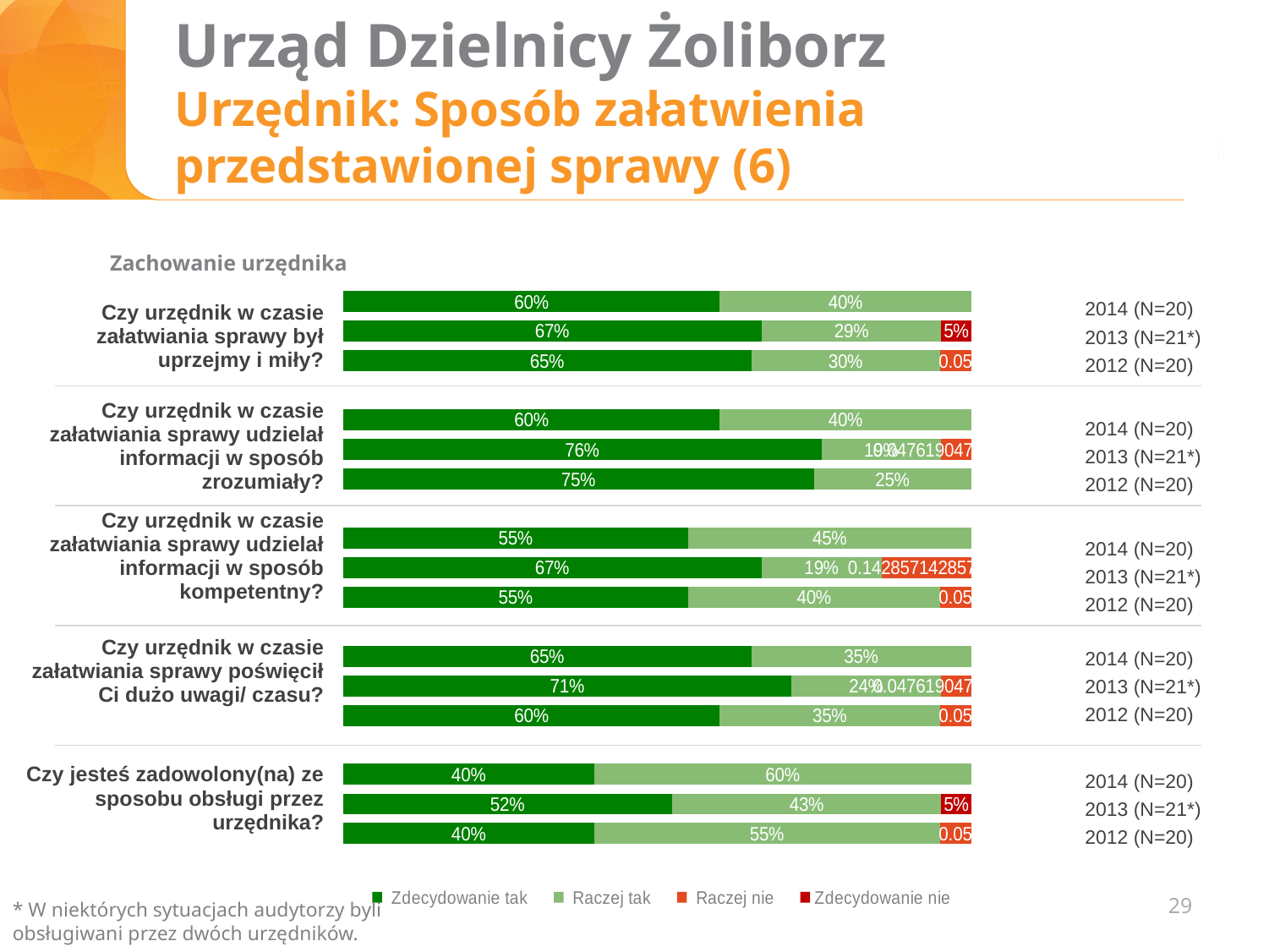
What is the 'Zdecydowanie tak' value for 2013 for the question 'Czy urzędnik w czasie załatwiania sprawy udzielał informacji w sposób zrozumiały?'? 76% What kind of chart is shown on the slide? bar chart For the question 'Czy urzędnik w czasie załatwiania sprawy poświęcił Ci dużo uwagi/ czasu?', is the 'Zdecydowanie tak' value larger in 2014 or in 2012? 2014 What is the 'Zdecydowanie tak' value for 2014 for the question 'Czy urzędnik w czasie załatwiania sprawy był uprzejmy i miły?'? 60% What is the 'Raczej tak' value for 2013 for the question 'Czy urzędnik w czasie załatwiania sprawy był uprzejmy i miły?'? 29% What is the sample size (N) shown for 2013? N=21* How many series does the legend list? 4 What is the 'Zdecydowanie tak' value for 2013 for the question 'Czy urzędnik w czasie załatwiania sprawy poświęcił Ci dużo uwagi/ czasu?'? 71% For the question 'Czy urzędnik w czasie załatwiania sprawy był uprzejmy i miły?', what is the difference between the 'Zdecydowanie tak' values for 2013 and 2014? 7% For the question 'Czy jesteś zadowolony(na) ze sposobu obsługi przez urzędnika?', which year has the lowest 'Raczej tak' value? 2013 For the question 'Czy urzędnik w czasie załatwiania sprawy udzielał informacji w sposób kompetentny?', which year has the highest 'Zdecydowanie tak' value? 2013 What is the 'Raczej tak' value for 2014 for the question 'Czy jesteś zadowolony(na) ze sposobu obsługi przez urzędnika?'? 60%